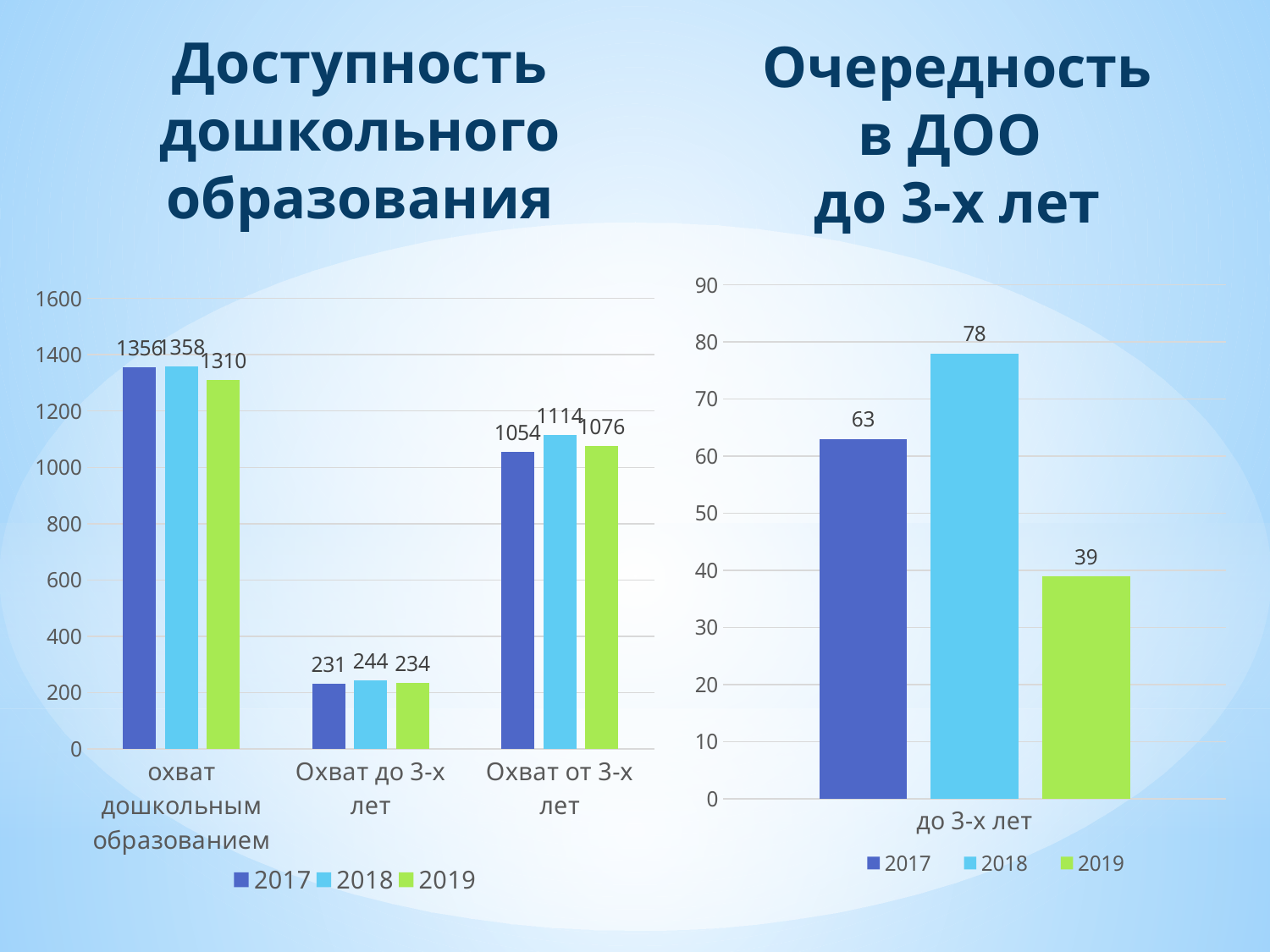
What kind of chart is the chart titled 'Очередность в ДОО до 3-х лет'? bar chart In the chart titled 'Очередность в ДОО до 3-х лет', what is the value for 2018? 78 In the chart titled 'Доступность дошкольного образования', what is the difference between the 2018 and 2017 values in the category 'Охват от 3-х лет'? 60 In the chart titled 'Доступность дошкольного образования', how many categories are shown on the x axis? 3 In the chart titled 'Очередность в ДОО до 3-х лет', what is the difference between the 2018 and 2019 values? 39 In the chart titled 'Очередность в ДОО до 3-х лет', what colour is the bar for 2019? green In the chart titled 'Доступность дошкольного образования', which year has the highest value in the category 'Охват от 3-х лет'? 2018 In the chart titled 'Очередность в ДОО до 3-х лет', which year has the lowest value? 2019 In the chart titled 'Доступность дошкольного образования', how many series does the legend list? 3 In the chart titled 'Доступность дошкольного образования', what is the value for 2019 in the category 'охват дошкольным образованием'? 1310 In the chart titled 'Доступность дошкольного образования', what is the value for 2018 in the category 'Охват до 3-х лет'? 244 In the chart titled 'Очередность в ДОО до 3-х лет', is the value for 2017 larger or smaller than the value for 2018? smaller